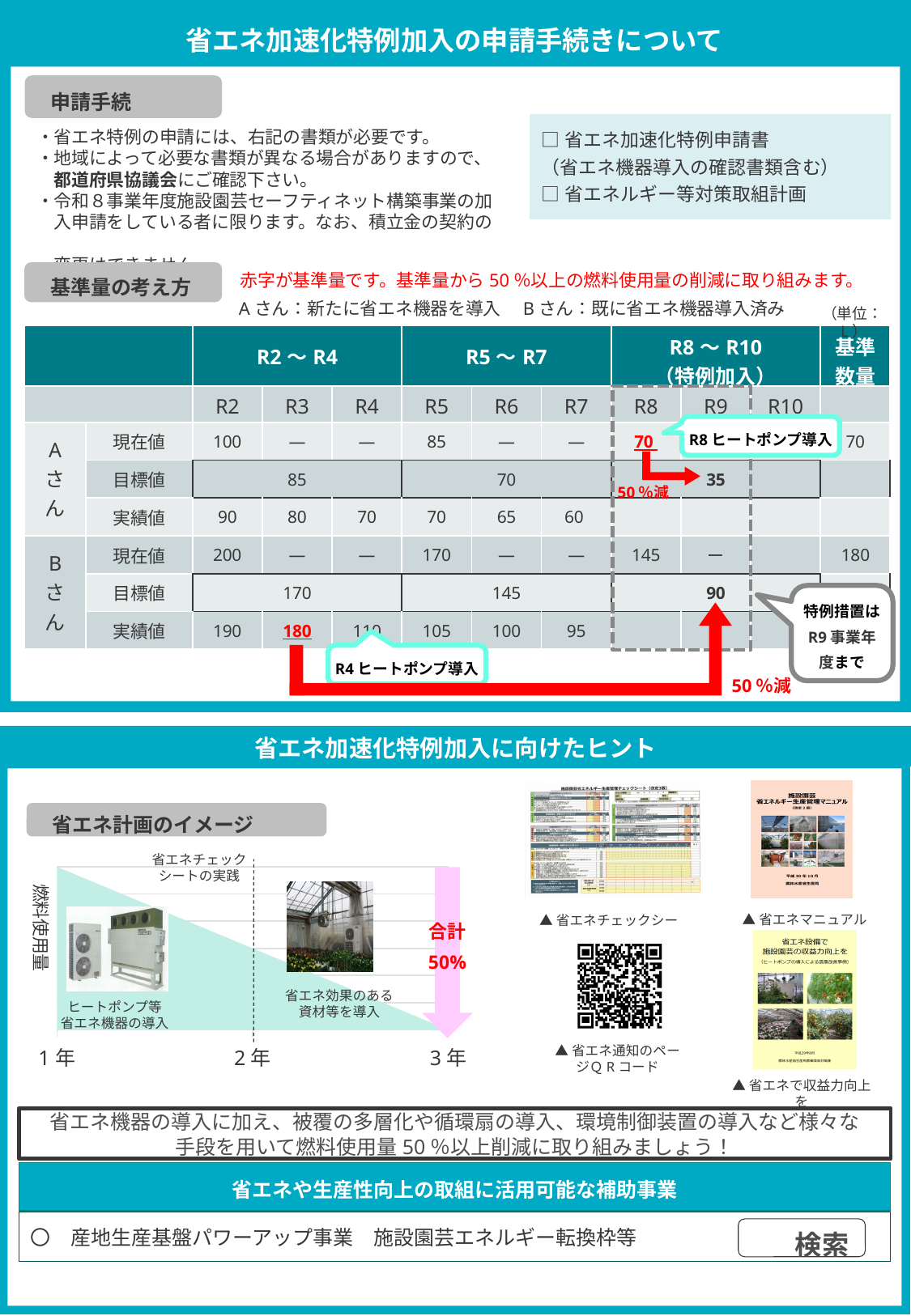
In the 省エネ計画のイメージ diagram, how many year points are marked along the horizontal axis? 3 In the 省エネ計画のイメージ diagram, does the fuel usage (燃料使用量) rise or fall from 1年 to 3年? fall In the 省エネ計画のイメージ diagram, what measure is introduced in the first period (1年) according to the label? ヒートポンプ等省エネ機器の導入 In the 省エネ計画のイメージ diagram, what total reduction is shown by the pink arrow at 3年? 合計50% In the 省エネ計画のイメージ diagram, what quantity is labelled on the vertical axis? 燃料使用量